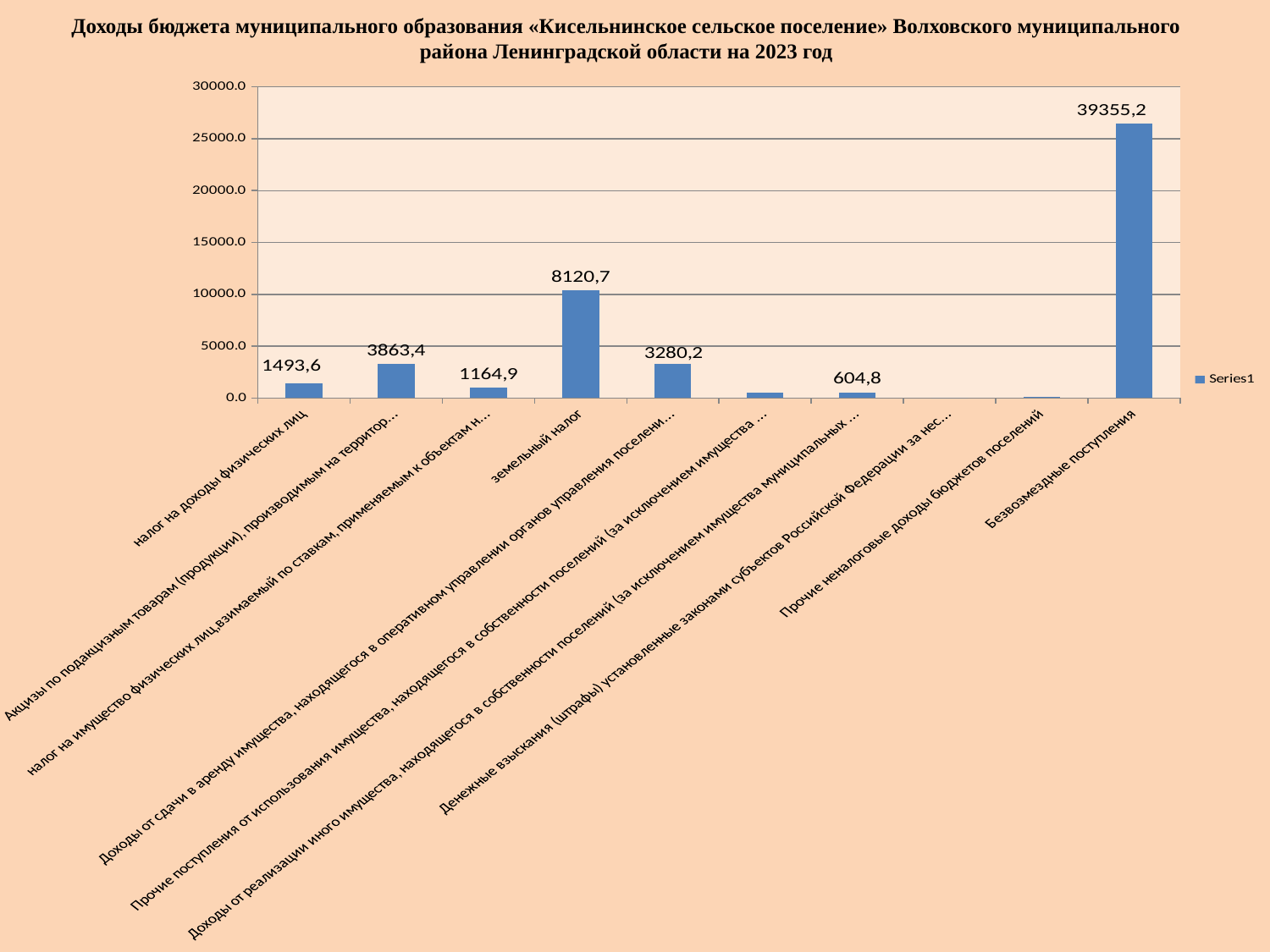
What is the difference between the Акцизы по подакцизным товарам bar (3863,4) and the Доходы от сдачи в аренду имущества bar (3280,2)? 583,2 What is the value for Безвозмездные поступления? 39355,2 Which is larger: налог на доходы физических лиц or налог на имущество физических лиц? налог на доходы физических лиц What kind of chart is shown on the slide? bar chart What is the difference between земельный налог and налог на доходы физических лиц? 6627,1 How many categories are shown on the x axis? 10 Is the value for Безвозмездные поступления greater or less than 20000? greater What is the value for налог на доходы физических лиц? 1493,6 What is the value for земельный налог? 8120,7 How many series does the legend list? 1 Which category has the highest value? Безвозмездные поступления